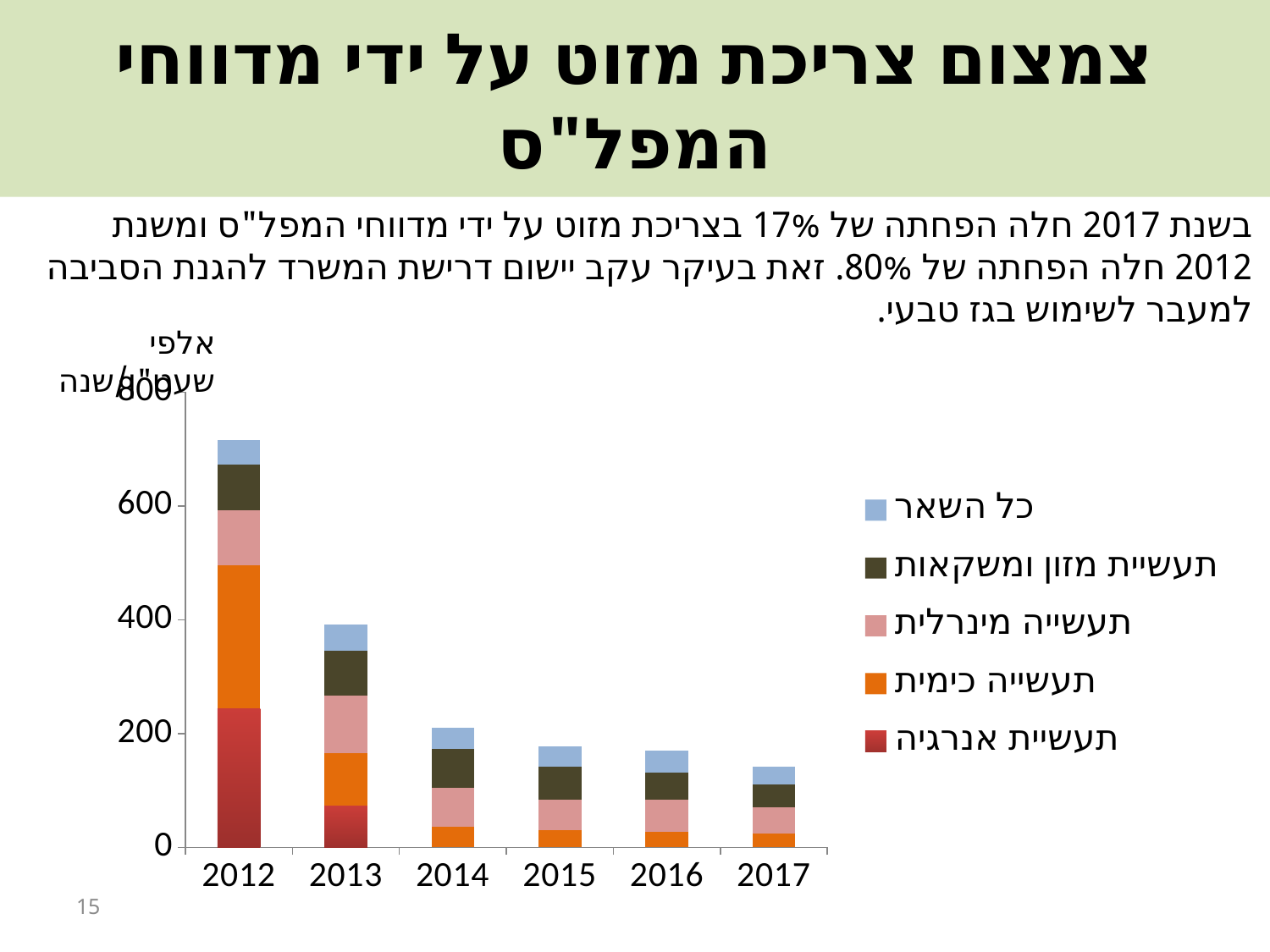
Which year has the lowest total bar in the chart? 2017 What kind of chart is shown on the slide? Stacked bar chart Which series is shown at the bottom of the stacked bars (in red)? תעשיית אנרגיה Is the total value for 2012 greater or less than 600? greater Which year has the highest total bar in the chart? 2012 How many series does the chart's legend list? 5 Is the total value for 2017 greater or less than 200? less Is the total value for 2013 greater or less than 200? greater Do the total bar heights rise or fall from 2012 to 2017? Fall Which series is listed first (at the top) in the chart's legend? כל השאר How many years (categories) are shown on the x axis of the chart? 6 Which total is larger, 2013 or 2016? 2013